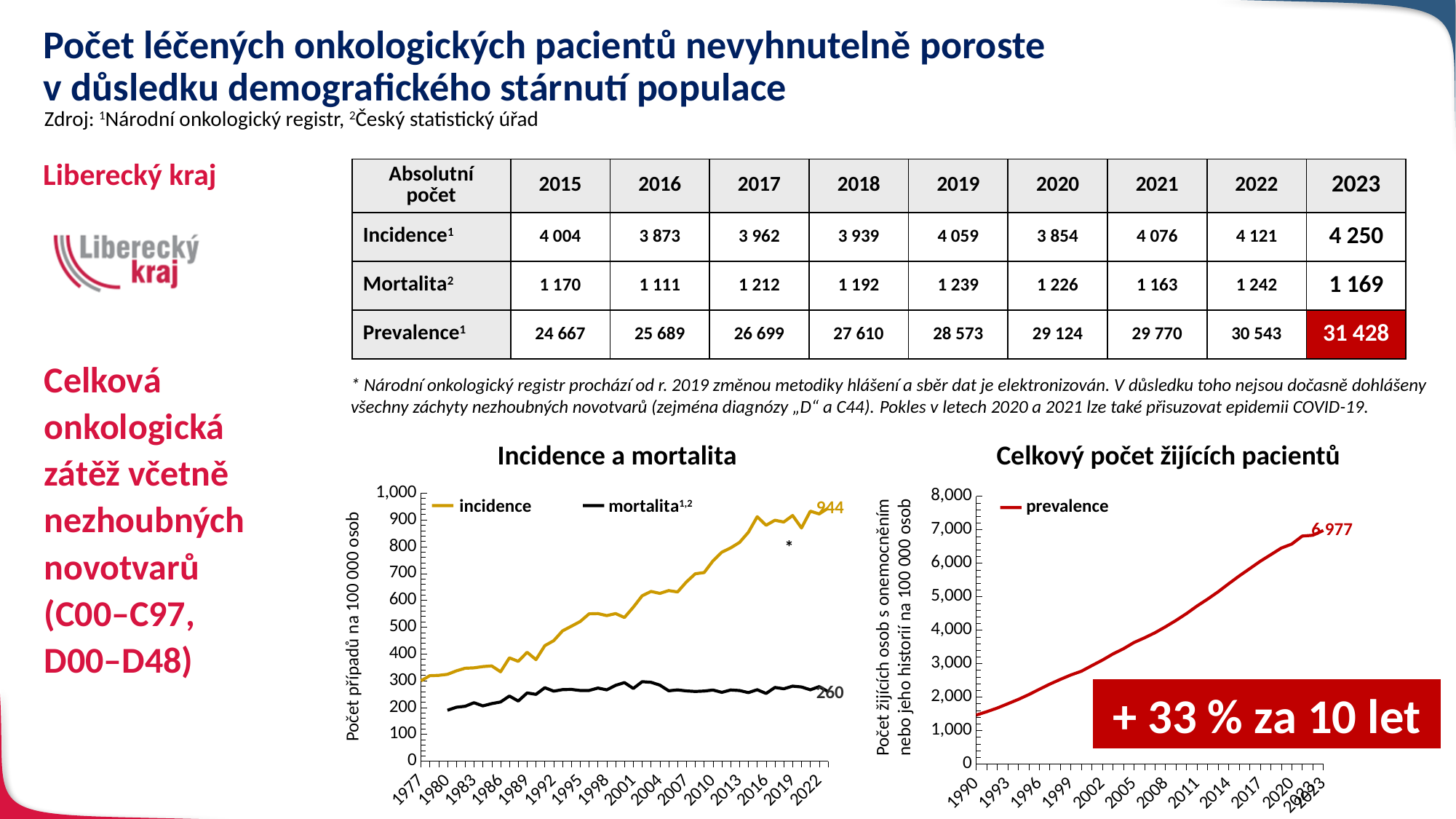
In the chart titled "Incidence a mortalita", does the incidence line generally rise or fall from 1977 to 2022? rise In the chart titled "Celkový počet žijících pacientů", what is the final labelled value of the prevalence series? 6 977 In the chart titled "Celkový počet žijících pacientů", does the prevalence line rise or fall from 1990 to 2023? rise In the chart titled "Incidence a mortalita", which series has the higher final labelled value, incidence or mortalita? incidence In the chart titled "Celkový počet žijících pacientů", is the prevalence value in 1990 greater or less than 2,000? less In the chart titled "Incidence a mortalita", what is the final labelled value of the incidence series? 944 In the chart titled "Incidence a mortalita", what is the difference between the final labelled incidence value and the final labelled mortalita value? 684 In the chart titled "Celkový počet žijících pacientů", how many series does the legend list? 1 In the chart titled "Incidence a mortalita", how many series does the legend list? 2 What kind of chart is the chart titled "Celkový počet žijících pacientů"? line chart In the chart titled "Incidence a mortalita", is the incidence value in 1977 greater or less than 400? less In the chart titled "Incidence a mortalita", what is the final labelled value of the mortalita series? 260